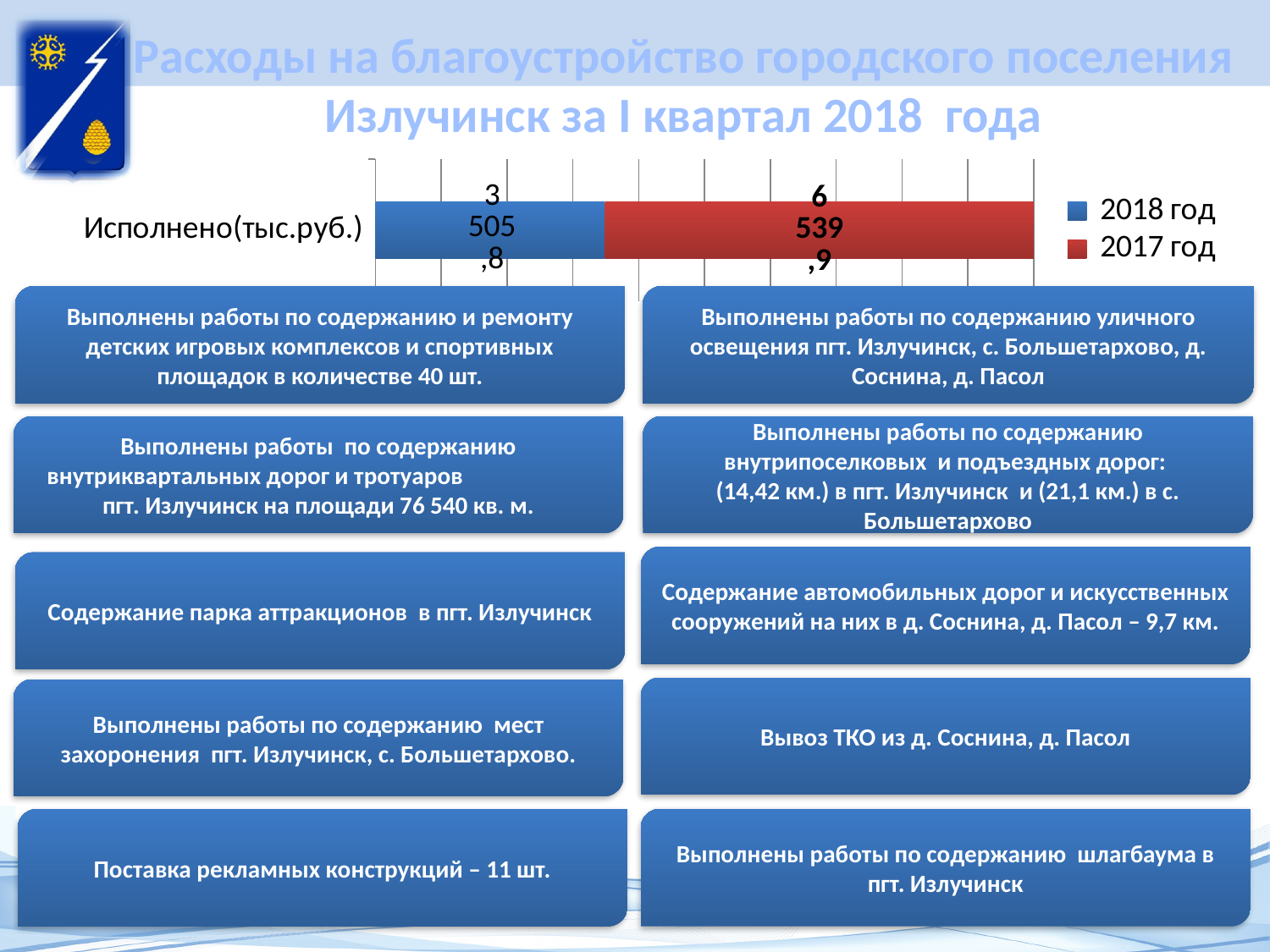
What is the total of the stacked bar for Исполнено(тыс.руб.)? 10 045,7 Which series has the larger value, 2018 год or 2017 год? 2017 год What is the category label shown on the chart's axis? Исполнено(тыс.руб.) How many series does the legend list? 2 What is the value for the 2017 год series in the chart? 6 539,9 What kind of chart is shown on the slide? Stacked bar chart What is the value for the 2018 год series in the chart? 3 505,8 What is the difference between the 2017 год value and the 2018 год value? 3 034,1 How many categories are plotted in the chart? 1 Which series has the lowest value in the chart? 2018 год Which colour represents the 2017 год series in the chart? Red Which series has the highest value in the chart? 2017 год